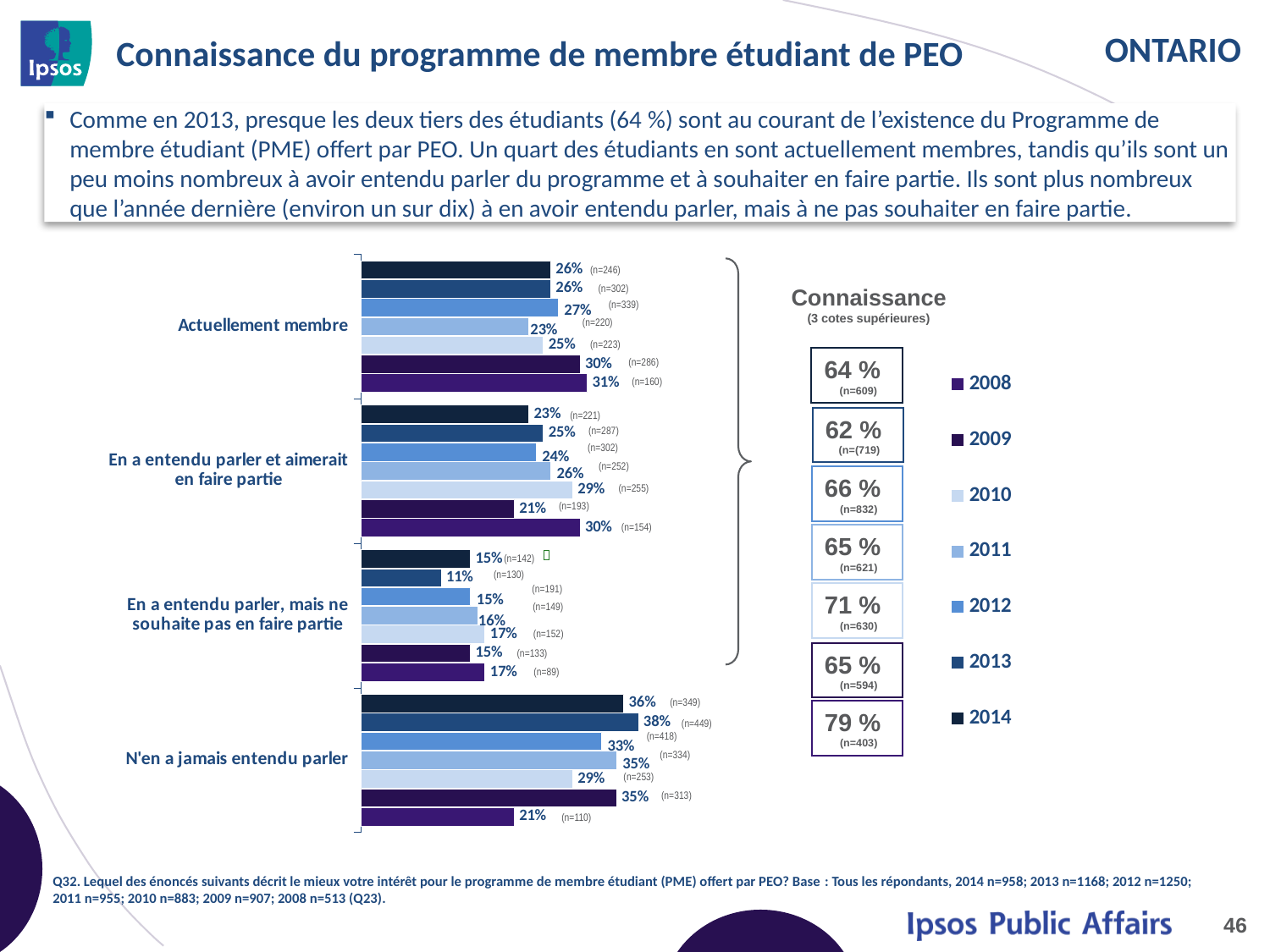
Which year has the highest 'Connaissance (3 cotes supérieures)' value? 2008 In the 'Connaissance (3 cotes supérieures)' boxes, what is the value for 2012? 66 % For 'N'en a jamais entendu parler', which is larger: the 2013 value or the 2014 value? 2013 In the 'Connaissance (3 cotes supérieures)' boxes, what is the value for 2014? 64 % What is the 2014 value for 'Actuellement membre'? 26% How many years (series) does the legend list? 7 Which year has the lowest 'Connaissance (3 cotes supérieures)' value? 2013 What kind of chart is shown on the slide? bar chart How many response categories are plotted on the bar chart? 4 What is the title of the slide's chart? Connaissance du programme de membre étudiant de PEO What is the 2008 value for 'N'en a jamais entendu parler'? 21% What is the difference between the 'Connaissance' values for 2014 and 2013? 2 percentage points